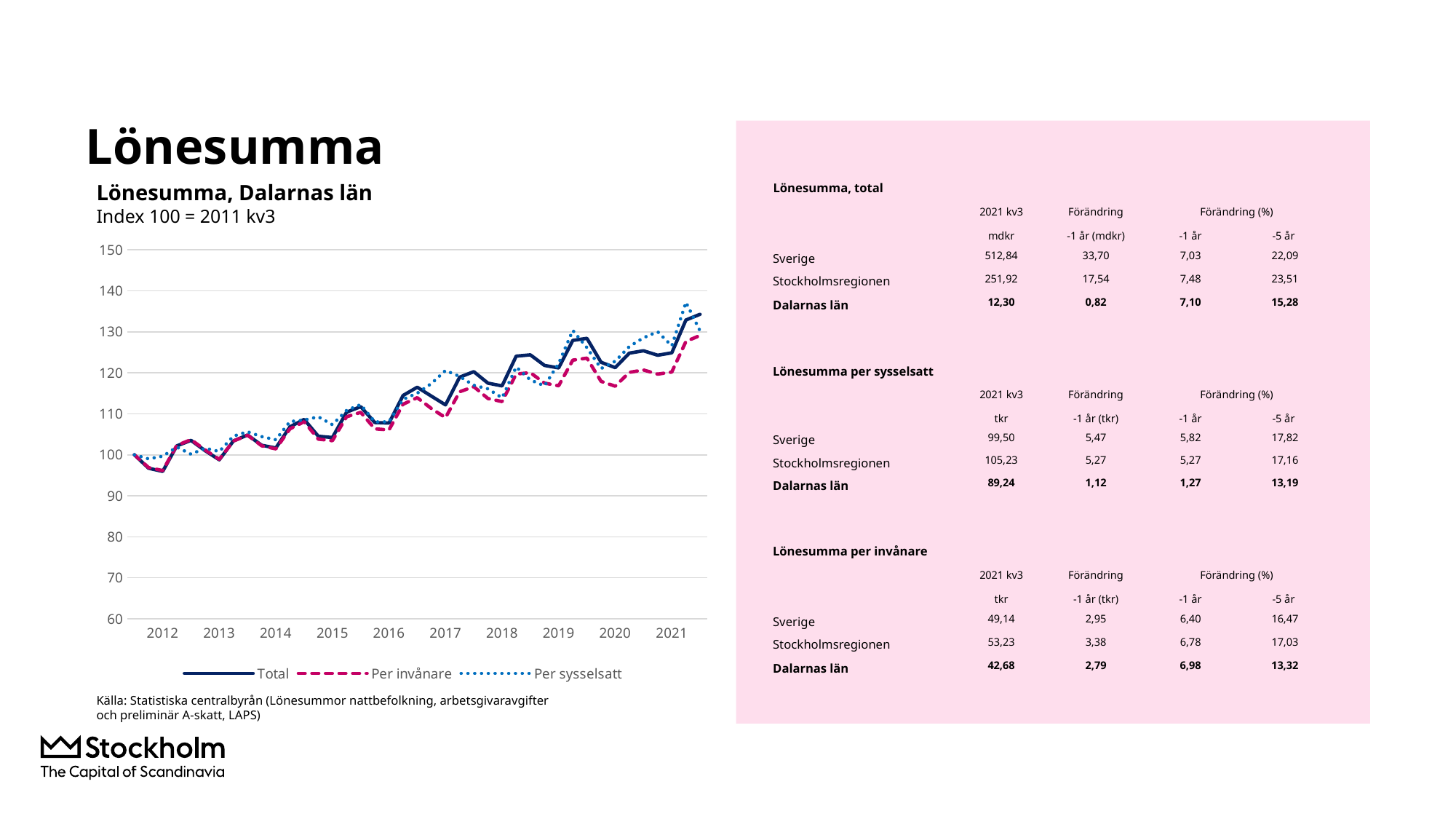
Which series are listed in the chart's legend? Total, Per invånare, Per sysselsatt What is the title of the chart? Lönesumma, Dalarnas län What is the highest value shown on the chart's vertical axis? 150 How many series does the legend of the chart list? 3 Which series has the lowest value at the end of 2021? Per invånare What kind of chart is shown on the slide? line chart Is the value of the Per invånare series at the end of 2021 greater or less than 120? greater Is the value of the Total series at the start of 2012 greater or less than 110? less Is the value of the Total series at the end of 2021 greater or less than 130? greater At the end of 2021, which series has the higher value: Total or Per invånare? Total Do the values of the Total series generally rise or fall from 2012 to 2021? rise